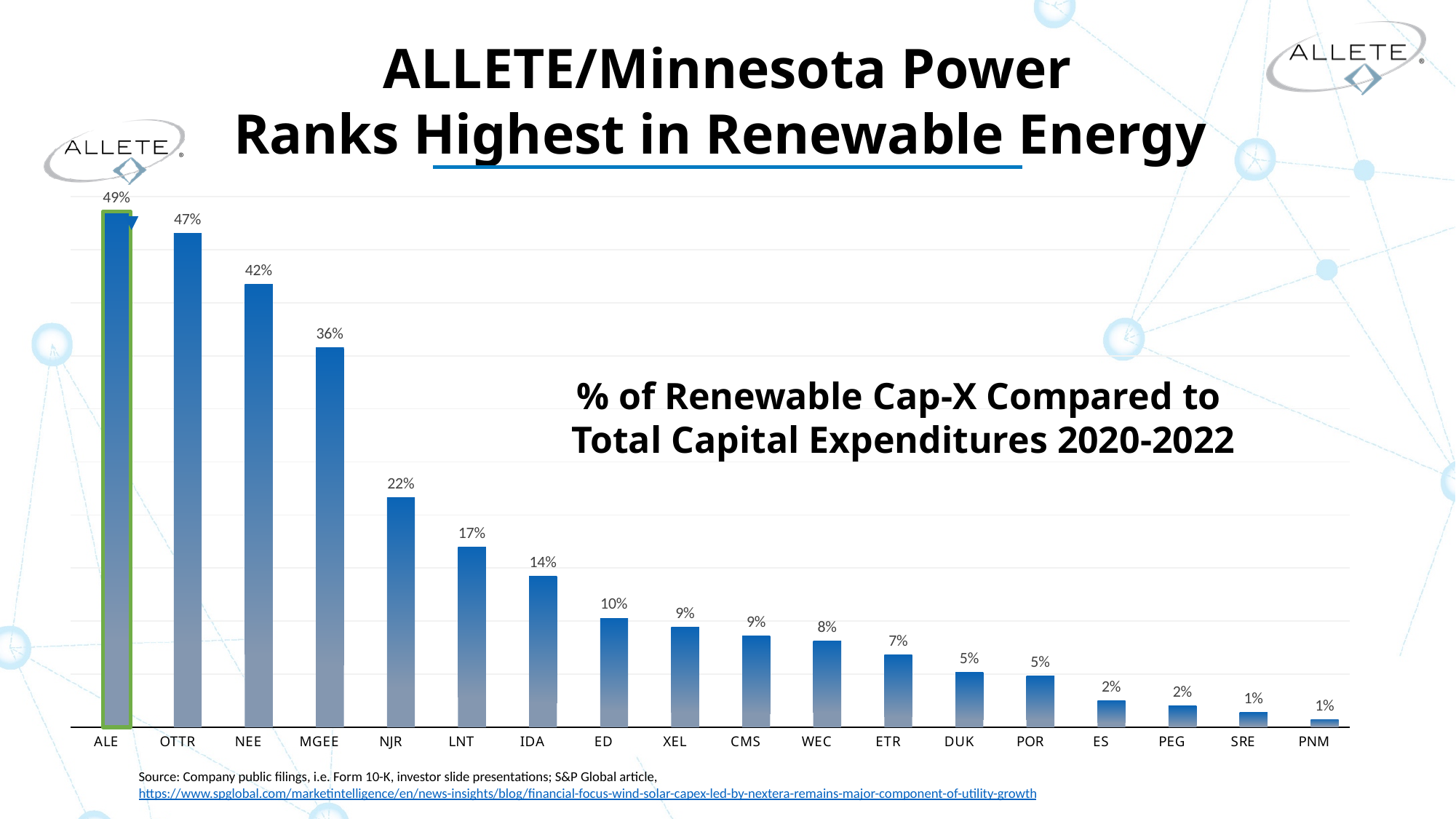
How many companies are shown on the x axis? 18 What is the difference between the values for ALE and OTTR? 2% What kind of chart is this? Bar chart What is the value for WEC? 8% Which company has the highest value? ALE What is the value for ALE? 49% Do the values rise or fall from left to right along the x axis? Fall Which is larger, the value for IDA or the value for ED? IDA What is the value for NJR? 22% What is the title of the chart? % of Renewable Cap-X Compared to Total Capital Expenditures 2020-2022 What is the difference between the values for NEE and LNT? 25% What is the value for MGEE? 36%